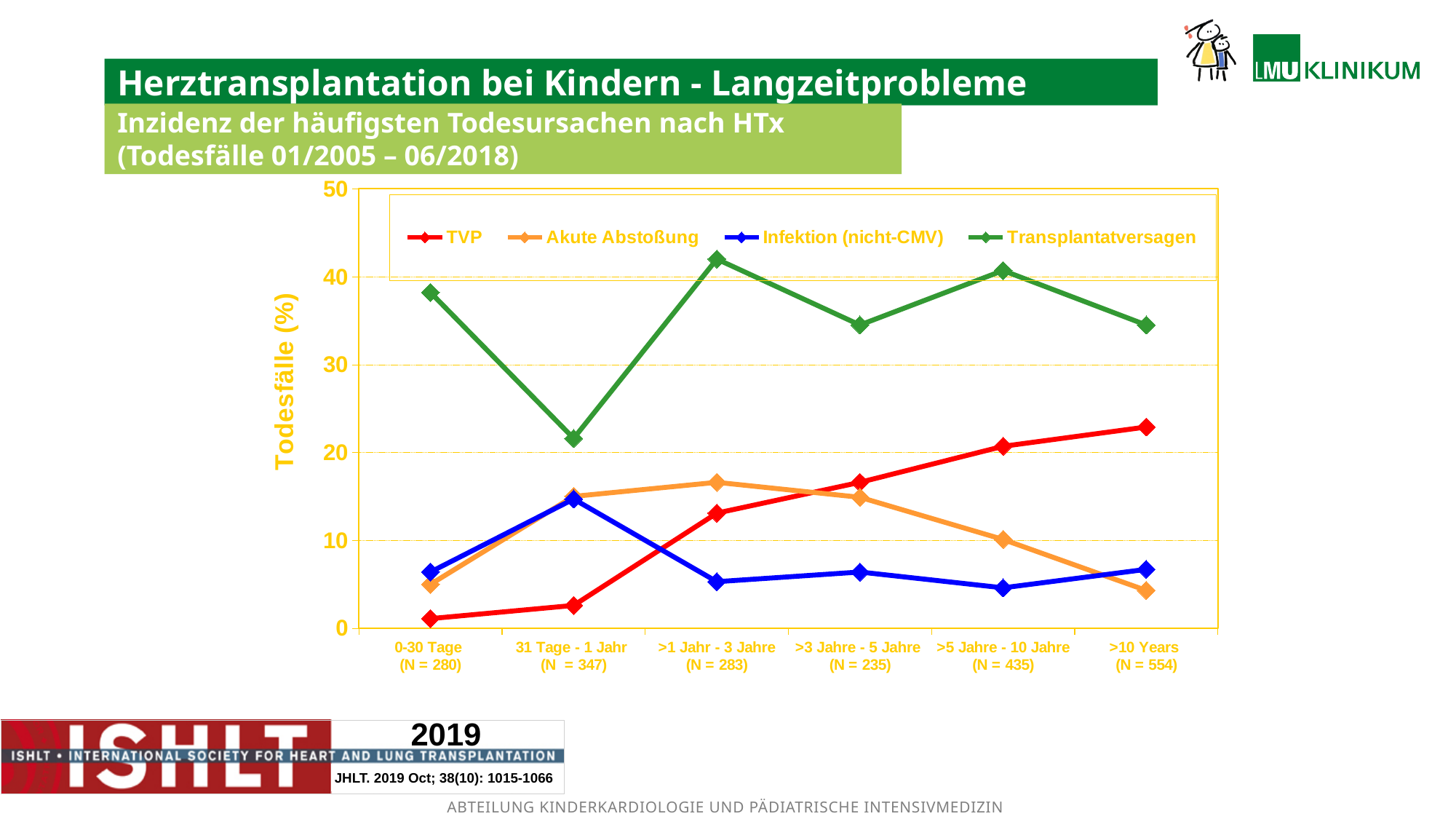
Is the value for Transplantatversagen at 0-30 Tage greater or less than 30? greater What is the label of the y axis? Todesfälle (%) How many time-period categories are shown on the x axis? 6 At >5 Jahre - 10 Jahre, which is larger: TVP or Akute Abstoßung? TVP In which time period is the value for TVP lowest? 0-30 Tage How many series does the legend list? 4 What kind of chart is shown on the slide? line chart In which time period is the value for TVP highest? >10 Years Does the TVP line rise or fall from 0-30 Tage to >10 Years? rise Is the value for Akute Abstoßung at >10 Years greater or less than 10? less Is the value for TVP at >10 Years greater or less than 20? greater In which time period is the value for Transplantatversagen lowest? 31 Tage - 1 Jahr